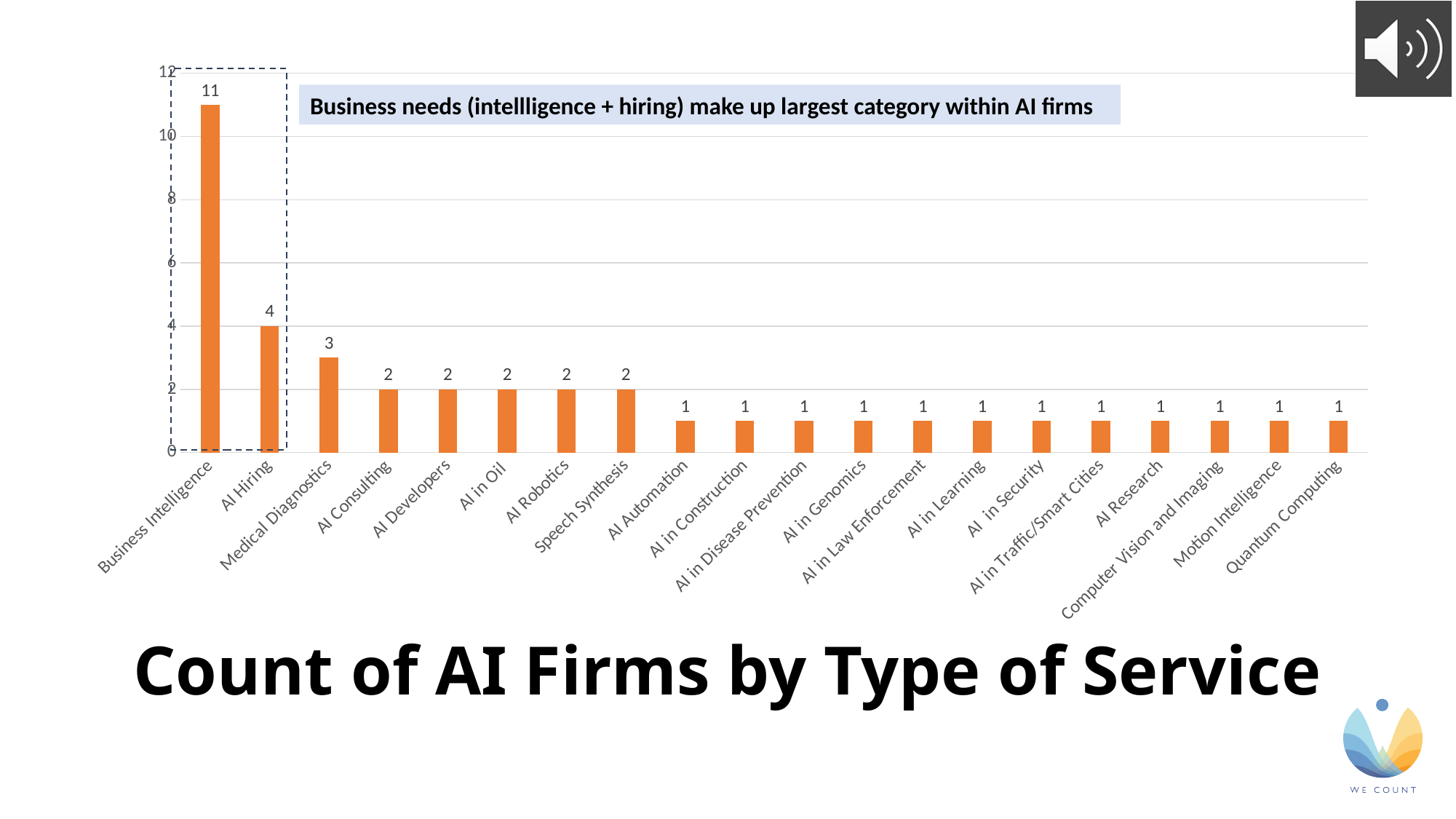
What kind of chart is shown on the slide? Bar chart What is the difference between the counts for Business Intelligence and AI Hiring? 7 What is the count of AI firms for Business Intelligence? 11 Which type of service has the highest count of AI firms? Business Intelligence What is the count of AI firms for Speech Synthesis? 2 How many types of service are shown on the x axis? 20 Which has a larger count of AI firms, Medical Diagnostics or AI Consulting? Medical Diagnostics Is the value for Business Intelligence greater or less than 10? greater What is the count of AI firms for Quantum Computing? 1 What is the count of AI firms for Medical Diagnostics? 3 What is the title of the chart? Count of AI Firms by Type of Service What is the count of AI firms for AI Hiring? 4